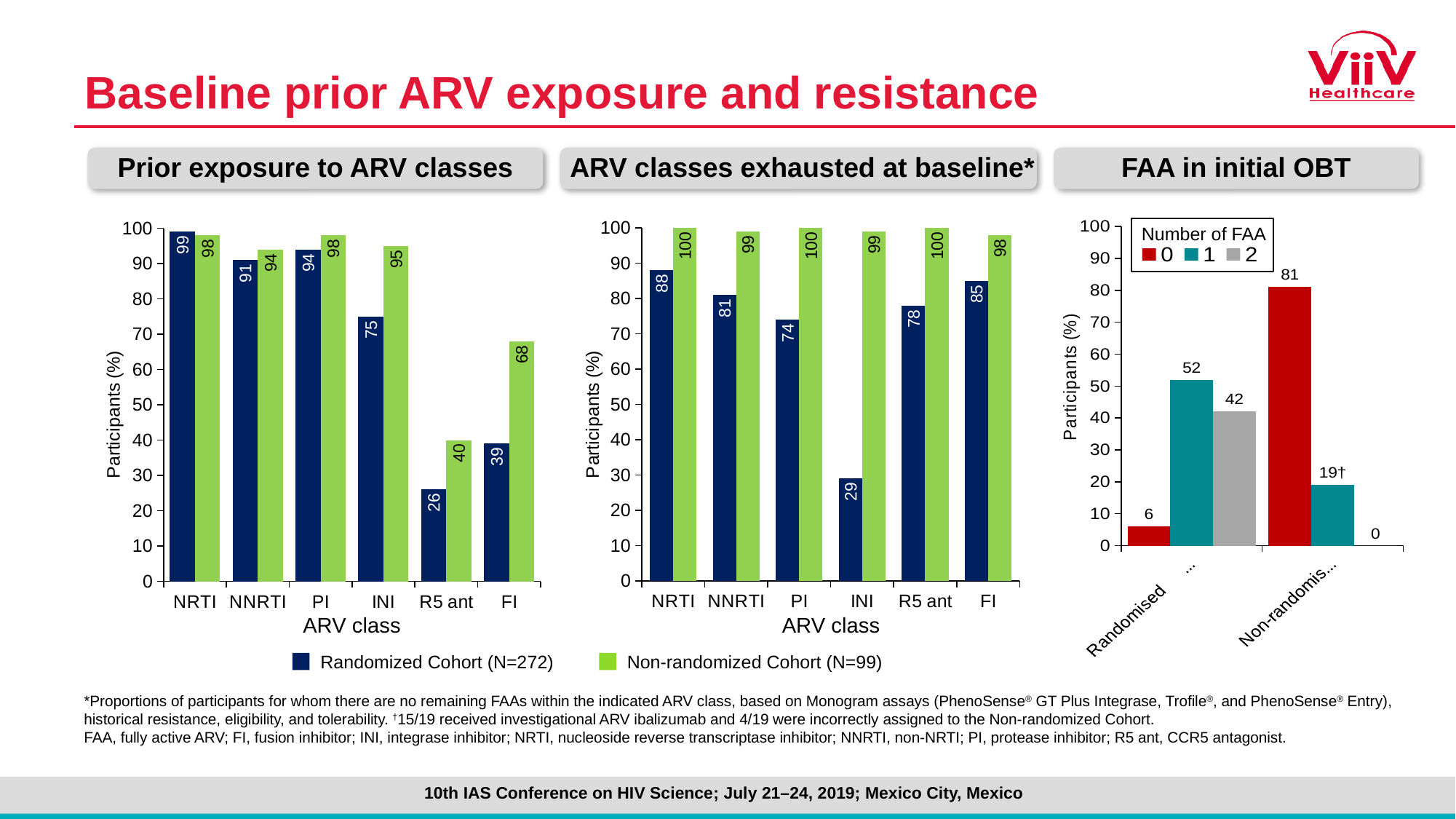
In the 'Prior exposure to ARV classes' chart, what is the value for the Randomized Cohort for INI? 75 In the 'Prior exposure to ARV classes' chart, which ARV class has the lowest value for the Randomized Cohort? R5 ant In the 'FAA in initial OBT' chart, what is the value for 0 FAA in the Non-randomised group? 81 In the 'FAA in initial OBT' chart, how many series does the legend list? 3 What kind of chart is the 'FAA in initial OBT' chart? Bar chart In the 'ARV classes exhausted at baseline*' chart, what is the value for the Randomized Cohort for INI? 29 In the 'ARV classes exhausted at baseline*' chart, which is larger for PI: the Randomized Cohort or the Non-randomized Cohort? Non-randomized Cohort In the 'ARV classes exhausted at baseline*' chart, which ARV class has the highest value for the Randomized Cohort? NRTI In the 'ARV classes exhausted at baseline*' chart, how many ARV classes are shown on the x axis? 6 In the 'Prior exposure to ARV classes' chart, what is the value for the Non-randomized Cohort for FI? 68 In the 'Prior exposure to ARV classes' chart, what is the difference between the Non-randomized and Randomized Cohort values for FI? 29 In the 'FAA in initial OBT' chart, what is the value for 0 FAA in the Randomised group? 6